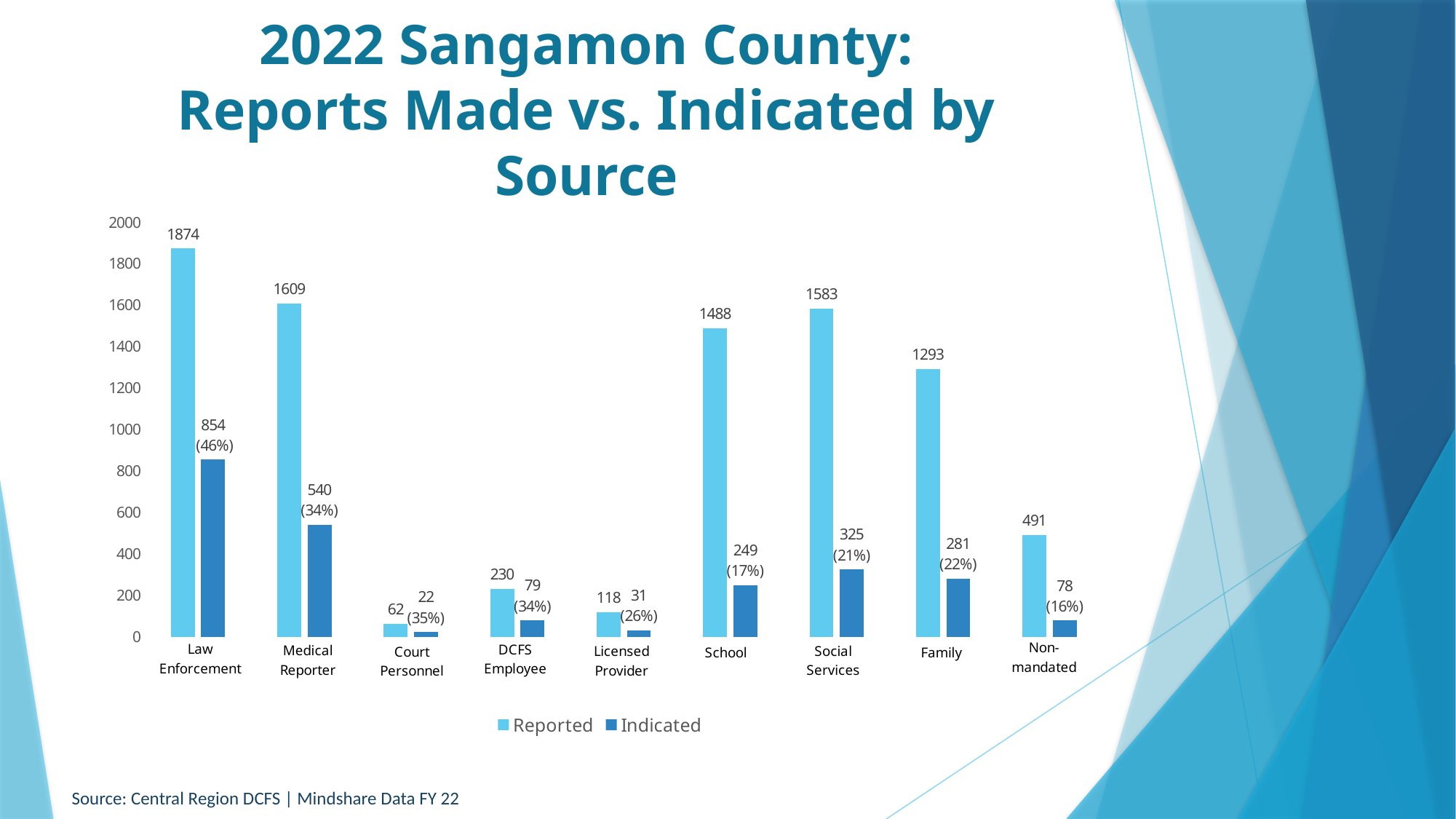
What is the Indicated value for Medical Reporter? 540 Which is larger, the Reported value for Family or the Reported value for School? School Which source has the lowest Indicated value? Court Personnel What kind of chart is shown on the slide? Bar chart Which source has the highest Reported value? Law Enforcement What is the difference between the Reported and Indicated values for Social Services? 1258 What is the title of the chart? 2022 Sangamon County: Reports Made vs. Indicated by Source How many series does the legend list? 2 What is the Reported value for School? 1488 What percentage is shown next to the Indicated value for Non-mandated? 16% How many source categories are shown on the x axis? 9 How many reports were made by Law Enforcement? 1874